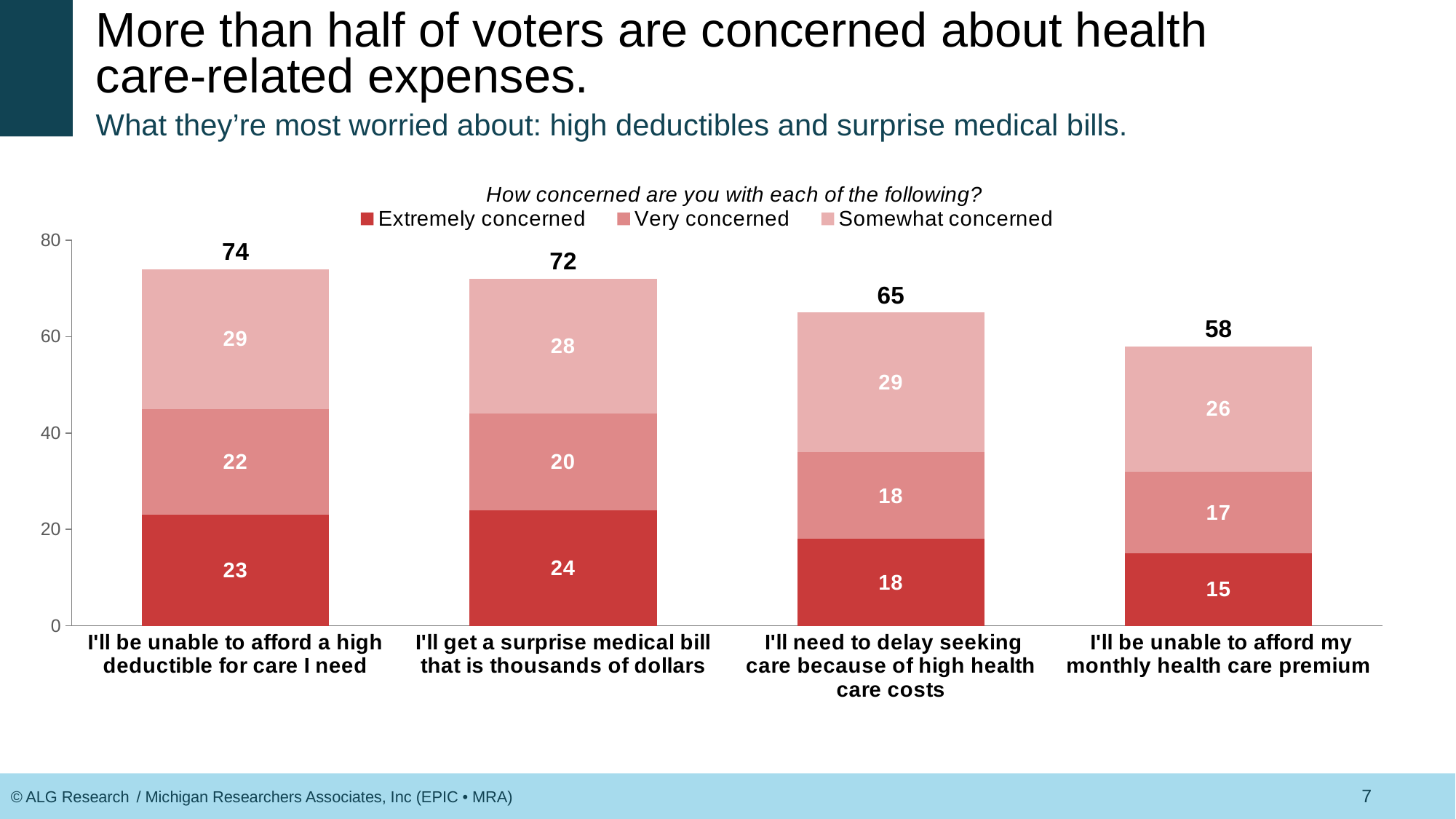
What is the 'Somewhat concerned' value for 'I'll get a surprise medical bill that is thousands of dollars'? 28 What is the difference between the totals for 'I'll be unable to afford a high deductible for care I need' and 'I'll be unable to afford my monthly health care premium'? 16 How many categories are shown on the x axis? 4 Which category has the highest total? I'll be unable to afford a high deductible for care I need What is the 'Very concerned' value for 'I'll be unable to afford my monthly health care premium'? 17 What is the total for the 'I'll need to delay seeking care because of high health care costs' bar? 65 What is the 'Extremely concerned' value for 'I'll be unable to afford a high deductible for care I need'? 23 Which category has the lowest total? I'll be unable to afford my monthly health care premium Which is larger: the 'Extremely concerned' value for 'I'll get a surprise medical bill that is thousands of dollars' or for 'I'll need to delay seeking care because of high health care costs'? I'll get a surprise medical bill that is thousands of dollars What is the title of the chart? How concerned are you with each of the following? What kind of chart is shown on the slide? Stacked bar chart How many series does the legend list? 3